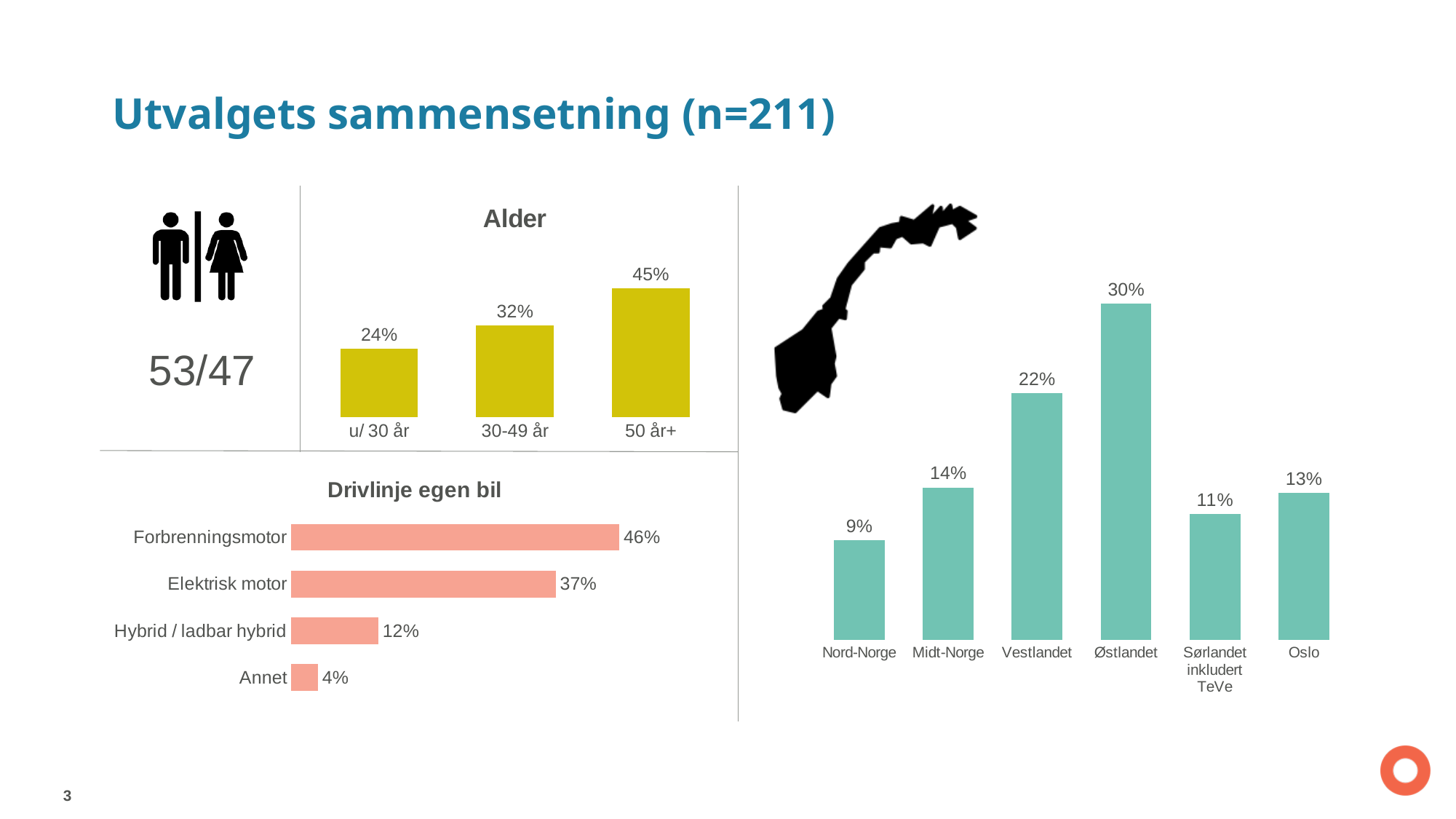
In the 'Alder' chart, what is the value for '50 år+'? 45% In the 'Drivlinje egen bil' chart, how many categories are shown? 4 In the 'Drivlinje egen bil' chart, what kind of chart is it? bar chart In the 'Alder' chart, which age group has the lowest value? u/ 30 år In the 'Drivlinje egen bil' chart, what is the difference between 'Forbrenningsmotor' and 'Hybrid / ladbar hybrid'? 34% In the region chart on the right, which region has the highest value? Østlandet In the 'Drivlinje egen bil' chart, which category has the highest value? Forbrenningsmotor In the region chart on the right, what is the value for 'Vestlandet'? 22% In the 'Alder' chart, what is the difference between '50 år+' and 'u/ 30 år'? 21% In the region chart on the right, which is larger, 'Midt-Norge' or 'Oslo'? Midt-Norge In the 'Alder' chart, do the values rise or fall from left to right along the x axis? rise In the 'Drivlinje egen bil' chart, what is the value for 'Elektrisk motor'? 37%